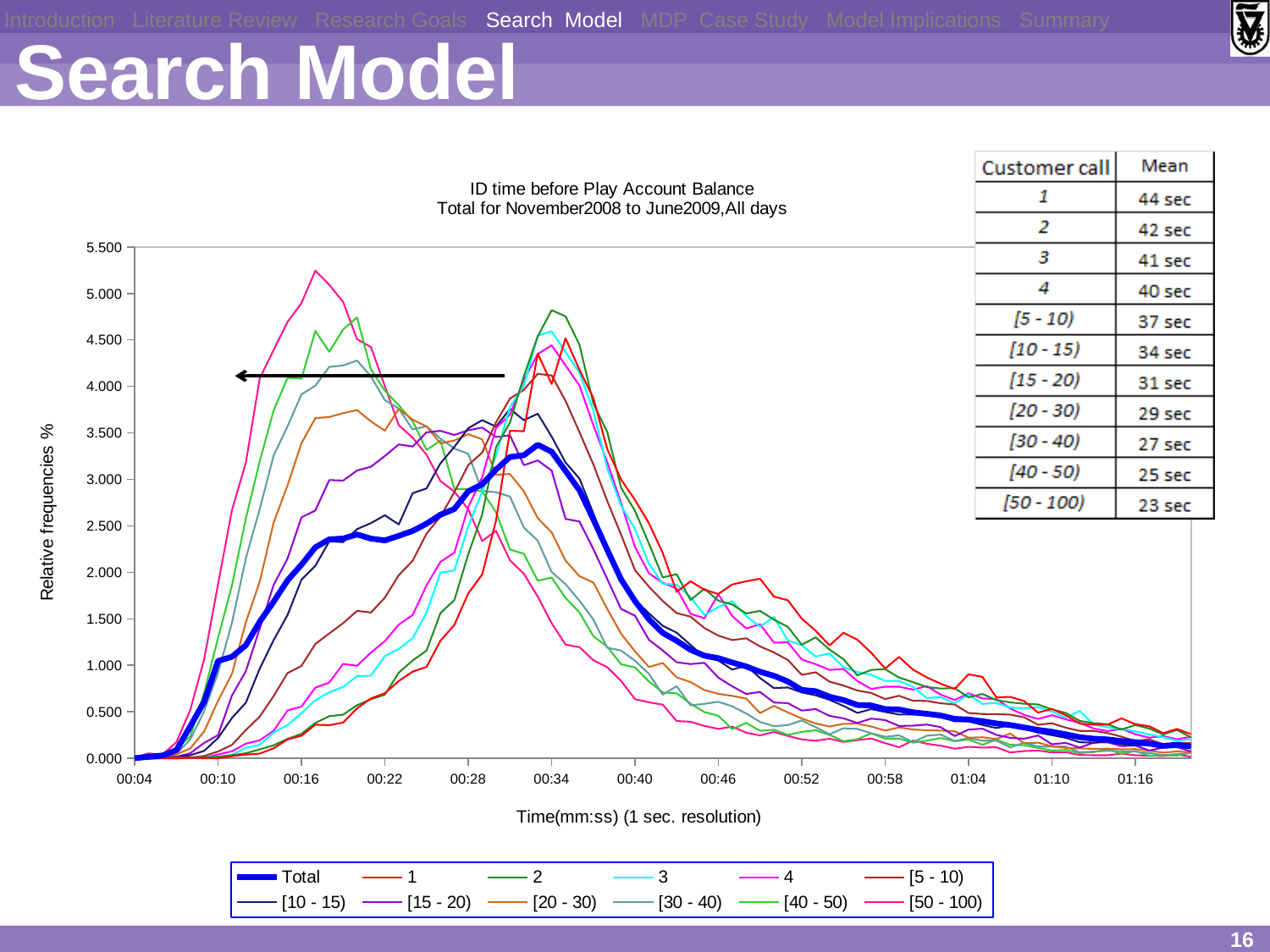
Does the Total series rise or fall between 00:34 and 01:16? fall What is the title of the chart? ID time before Play Account Balance Total for November2008 to June2009,All days How many series does the chart legend list? 12 What kind of chart is shown on the slide? line chart What is the label of the y axis of the chart? Relative frequencies % How many tick labels are shown on the x axis of the chart? 13 Which series reaches the highest peak value in the chart? [50 - 100) Is the peak value of the Total series greater or less than 3.000? greater At 00:16, which series has the larger value, [50 - 100) or Total? [50 - 100) What is the highest tick value shown on the y axis of the chart? 5.500 Is the peak value of the [50 - 100) series greater or less than 5.000? greater Is the value of the Total series at 00:10 greater or less than 1.500? less